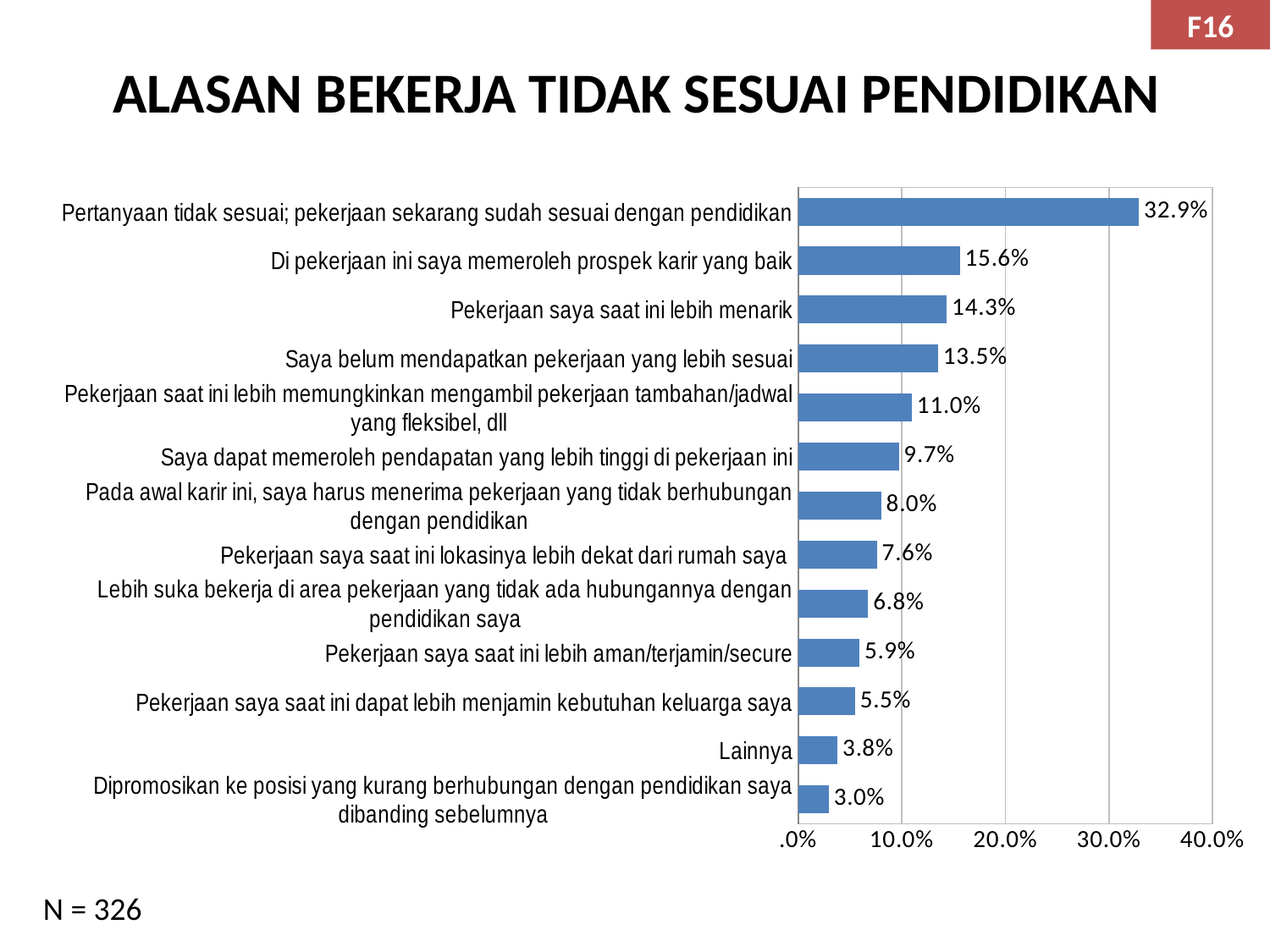
What is the value for "Lainnya"? 3.8% What is the sample size (N) shown on the slide? N = 326 What is the difference between the values for "Di pekerjaan ini saya memeroleh prospek karir yang baik" and "Pekerjaan saya saat ini lebih menarik"? 1.3% How many categories are shown in the chart? 13 Which is larger: the value for "Pekerjaan saya saat ini lokasinya lebih dekat dari rumah saya" or the value for "Pekerjaan saya saat ini lebih aman/terjamin/secure"? Pekerjaan saya saat ini lokasinya lebih dekat dari rumah saya What kind of chart is shown on the slide? bar chart What is the value for "Saya dapat memeroleh pendapatan yang lebih tinggi di pekerjaan ini"? 9.7% What is the value for "Pekerjaan saya saat ini lebih menarik"? 14.3% Which category has the lowest value? Dipromosikan ke posisi yang kurang berhubungan dengan pendidikan saya dibanding sebelumnya What is the title of the slide? ALASAN BEKERJA TIDAK SESUAI PENDIDIKAN Which category has the highest value? Pertanyaan tidak sesuai; pekerjaan sekarang sudah sesuai dengan pendidikan Is the value for "Saya belum mendapatkan pekerjaan yang lebih sesuai" greater or less than 10.0%? greater